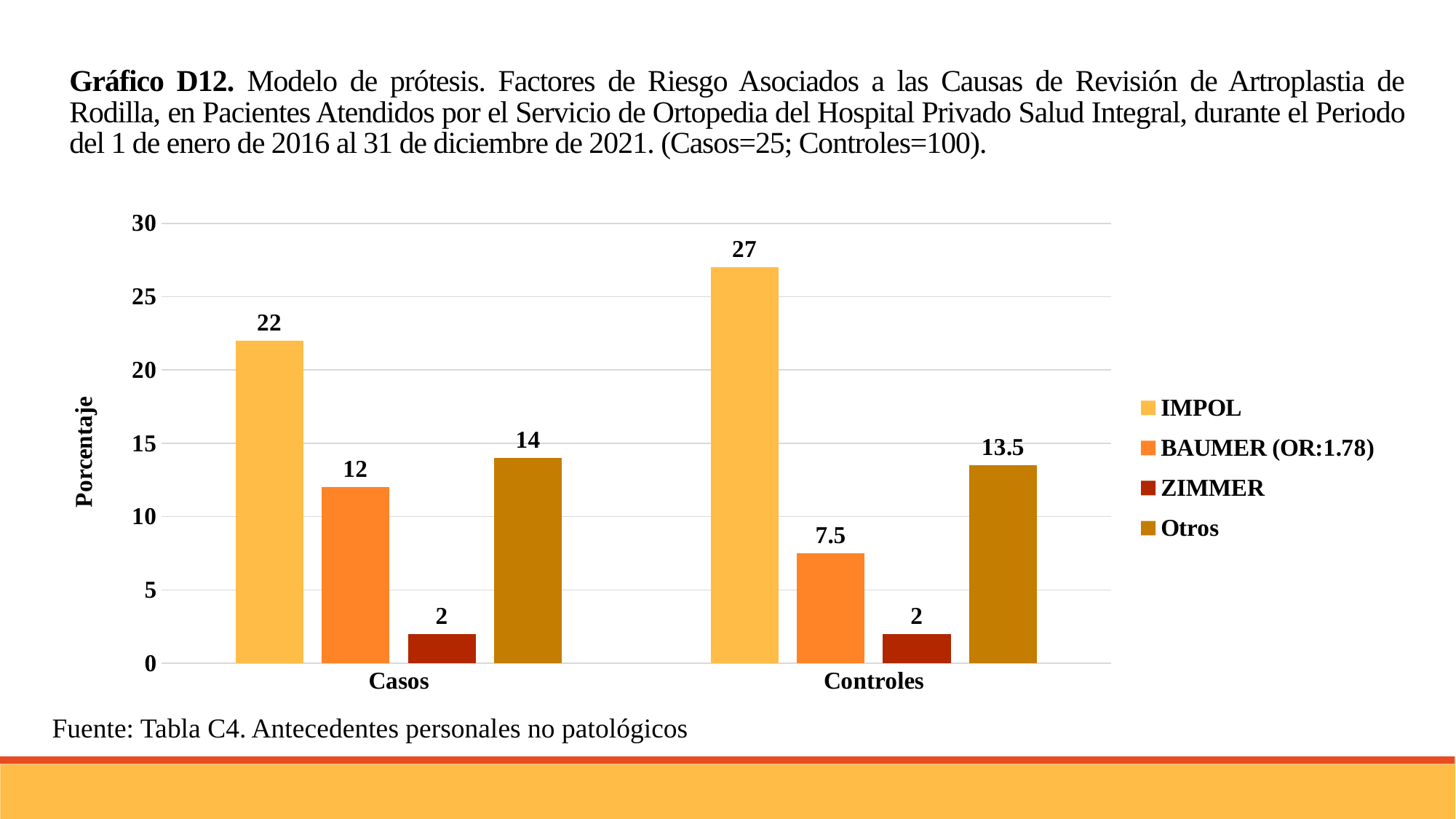
What is the value for BAUMER (OR:1.78) in the Controles group? 7.5 Which series has the lowest value in the Casos group? ZIMMER What is the difference between the IMPOL values for Controles and Casos? 5 What kind of chart is shown on the slide? bar chart What is the label of the vertical axis? Porcentaje Which series has the highest value in the Controles group? IMPOL Which is larger: Otros for Casos or Otros for Controles? Otros for Casos Is the value for IMPOL in the Controles group greater or less than 25? greater What is the value for Otros in the Controles group? 13.5 What is the value for IMPOL in the Casos group? 22 How many series does the legend list? 4 What is the difference between the BAUMER (OR:1.78) values for Casos and Controles? 4.5